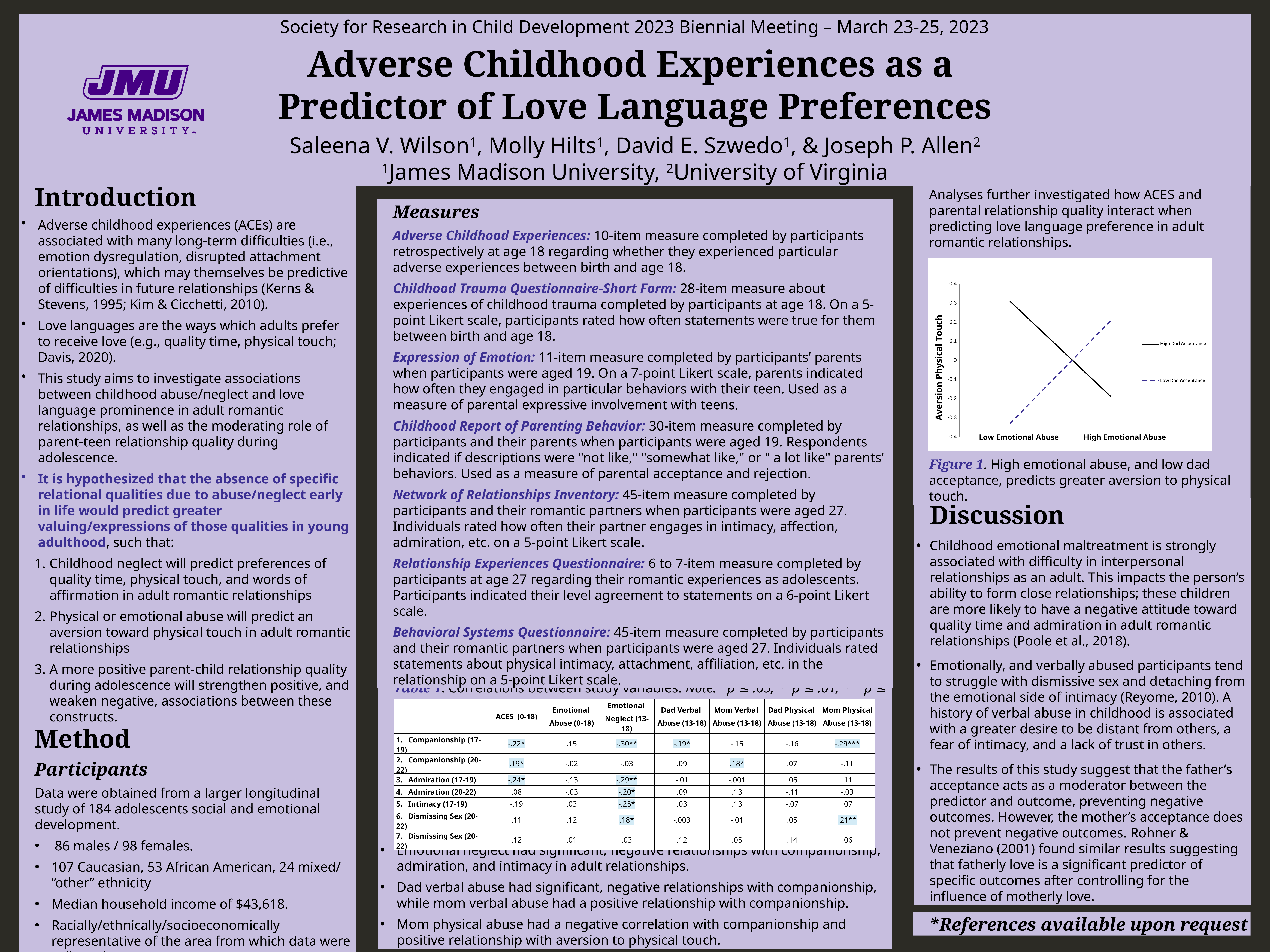
How many series does the legend of Figure 1 list? 2 What is the label on the y axis of Figure 1? Aversion Physical Touch In Figure 1, is the Low Dad Acceptance value at Low Emotional Abuse greater or less than -0.2? less In Figure 1, which series has the higher value at High Emotional Abuse? Low Dad Acceptance In Figure 1, is the High Dad Acceptance value at Low Emotional Abuse greater or less than 0.2? greater In Figure 1, is the Low Dad Acceptance value at High Emotional Abuse greater or less than 0.1? greater In Figure 1, does the Low Dad Acceptance line rise or fall from Low Emotional Abuse to High Emotional Abuse? rise What kind of chart is Figure 1 on the slide? line chart In Figure 1, does the High Dad Acceptance line rise or fall from Low Emotional Abuse to High Emotional Abuse? fall How many categories are shown on the x axis of Figure 1? 2 In Figure 1, which series has the higher value at Low Emotional Abuse? High Dad Acceptance